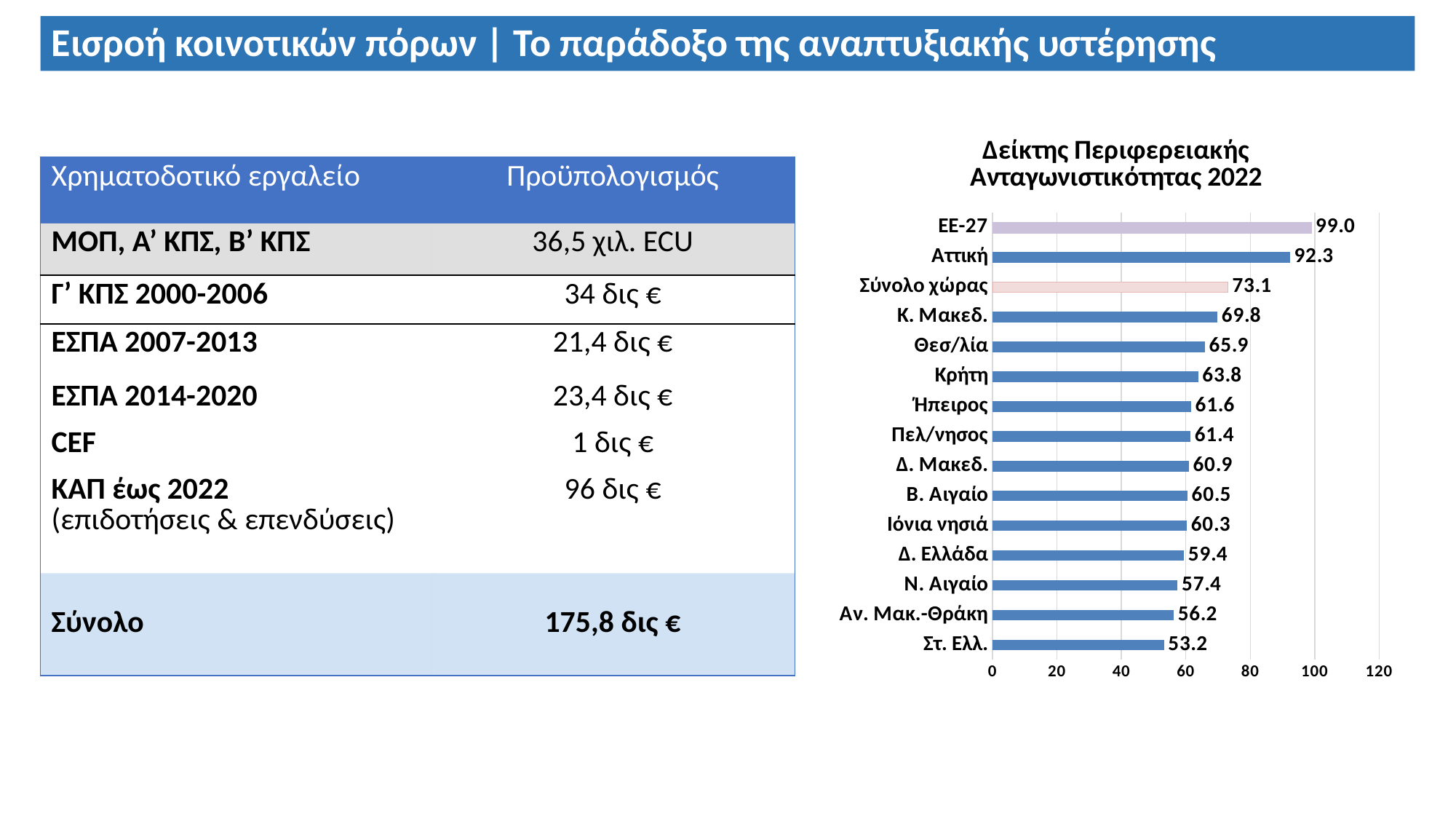
What is the difference between the values for ΕΕ-27 and Αττική? 6.7 Which category has the lowest value in the chart? Στ. Ελλ. What is the value for Σύνολο χώρας in the chart? 73.1 What is the value for Αττική in the chart? 92.3 What is the difference between the values for Σύνολο χώρας and Στ. Ελλ.? 19.9 How many bars are shown in the chart? 15 What is the title of the chart? Δείκτης Περιφερειακής Ανταγωνιστικότητας 2022 What is the value for Κρήτη in the chart? 63.8 Which category has the highest value in the chart? ΕΕ-27 Which has a larger value, Κ. Μακεδ. or Θεσ/λία? Κ. Μακεδ. Is the value for Ήπειρος greater or less than 80? less What type of chart is shown on the slide? bar chart